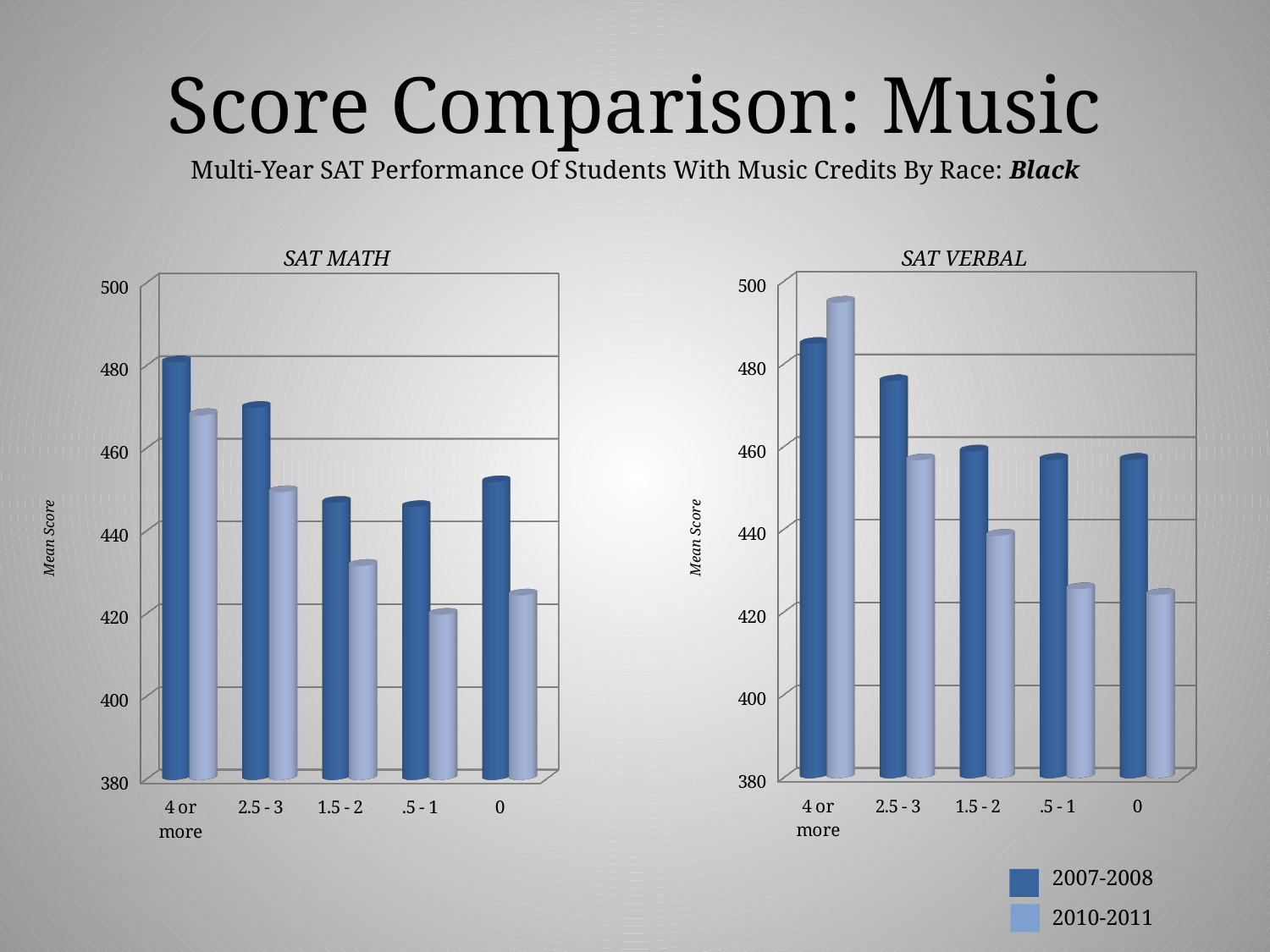
In the SAT VERBAL chart, for the '4 or more' category, which series has the larger value, 2007-2008 or 2010-2011? 2010-2011 What is the label on the vertical axis of both charts? Mean Score In the SAT VERBAL chart, do the 2010-2011 values rise or fall moving from '4 or more' to '0' along the x axis? fall In the SAT MATH chart, which category has the highest 2007-2008 score? 4 or more What kind of chart is the SAT MATH chart? bar chart In the SAT MATH chart, is the 2010-2011 value for '1.5 - 2' greater or less than 440? less How many series does the legend list? 2 In the SAT MATH chart, is the 2010-2011 value for '4 or more' greater or less than 460? greater In the SAT VERBAL chart, which category has the highest 2010-2011 score? 4 or more In the SAT VERBAL chart, is the 2010-2011 value for '.5 - 1' greater or less than 440? less How many music-credit categories are shown on the x axis of the SAT VERBAL chart? 5 In the SAT MATH chart, for the '4 or more' category, which series has the larger value, 2007-2008 or 2010-2011? 2007-2008